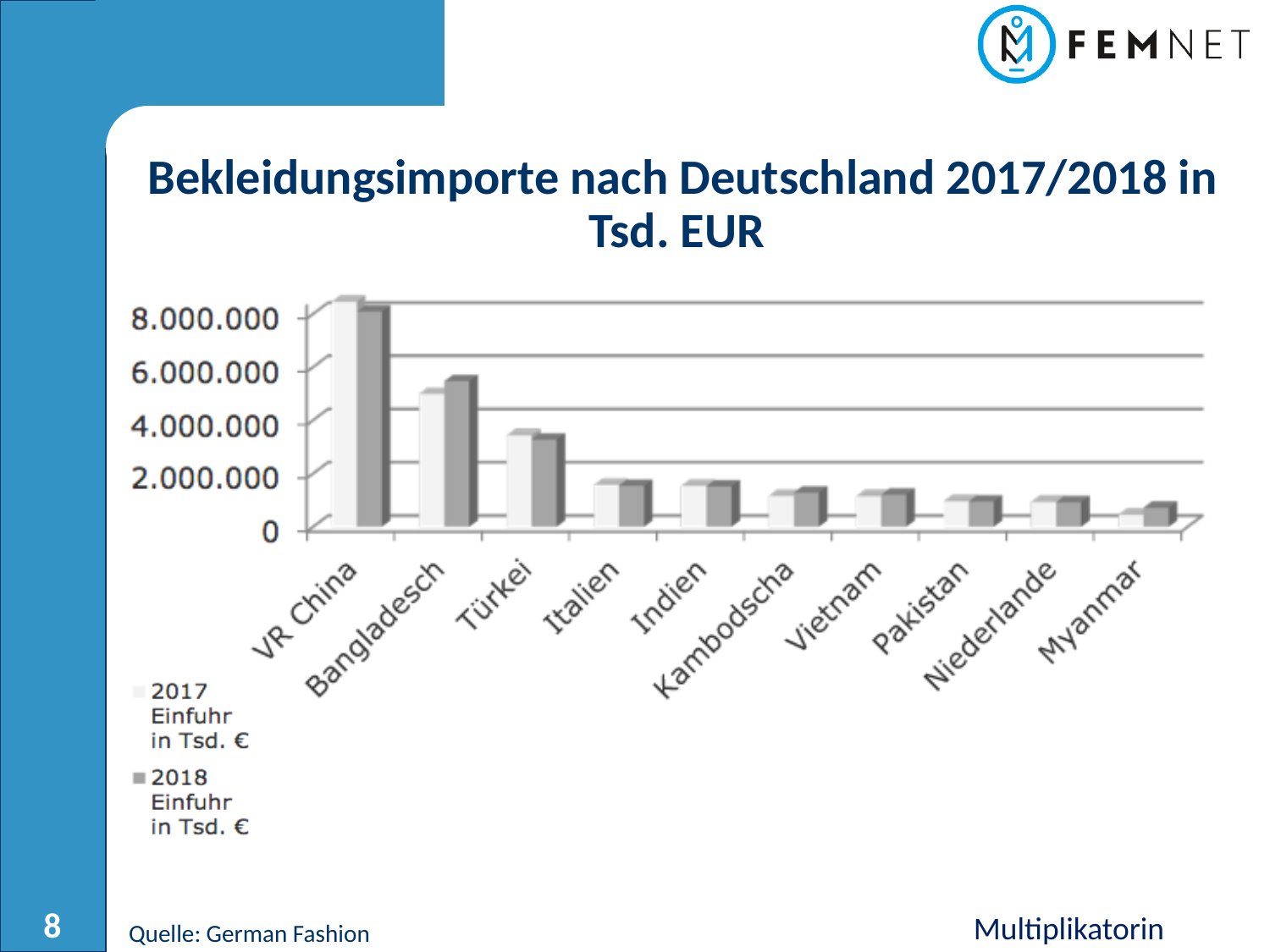
Is the 2018 import value for Italien greater or less than 2.000.000? less Do the import values generally rise or fall moving from left to right along the x axis? fall What is the title of the chart? Bekleidungsimporte nach Deutschland 2017/2018 in Tsd. EUR Which country has the lowest 2018 import value? Myanmar Is the 2017 import value for VR China greater or less than 8.000.000? greater Which is larger: the 2018 import value for VR China or the 2018 import value for Bangladesch? VR China Which country has the highest 2017 import value? VR China How many countries are shown on the x axis of the chart? 10 How many series does the legend list? 2 Is the 2018 import value for Bangladesch greater or less than 4.000.000? greater What kind of chart is shown on the slide? bar chart